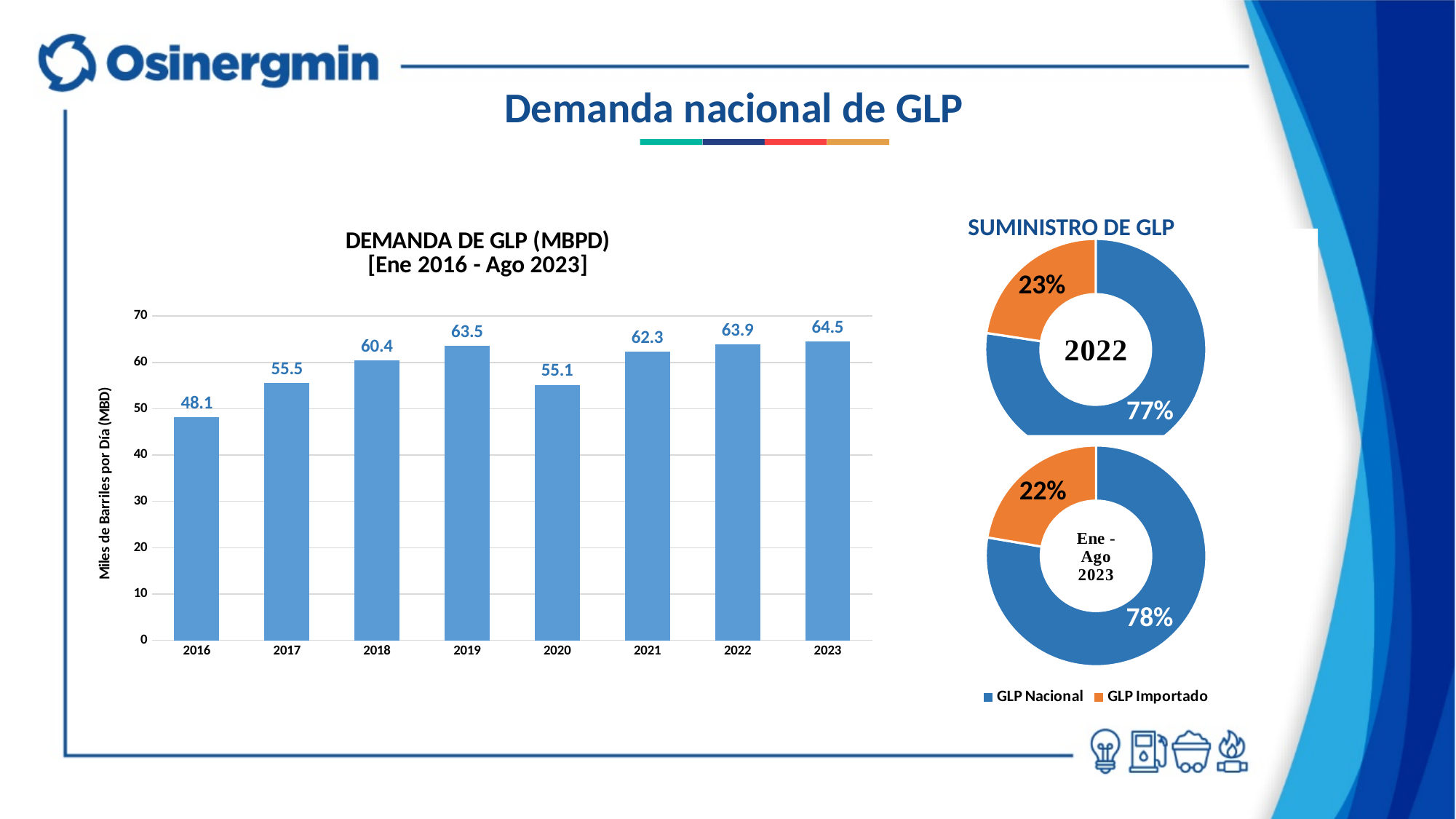
In the SUMINISTRO DE GLP 2022 donut chart, what share is GLP Importado? 23% In the SUMINISTRO DE GLP Ene - Ago 2023 donut chart, what share is GLP Nacional? 78% In the DEMANDA DE GLP (MBPD) bar chart, which year has the lowest value? 2016 In the DEMANDA DE GLP (MBPD) bar chart, which is larger, the value for 2018 or the value for 2021? 2021 In the DEMANDA DE GLP (MBPD) bar chart, what is the y-axis label? Miles de Barriles por Día (MBD) What kind of chart is the DEMANDA DE GLP (MBPD) chart? Bar chart In the DEMANDA DE GLP (MBPD) bar chart, what is the difference between the values for 2019 and 2020? 8.4 In the DEMANDA DE GLP (MBPD) bar chart, which year has the highest value? 2023 In the DEMANDA DE GLP (MBPD) bar chart, how many years are shown on the x axis? 8 In the DEMANDA DE GLP (MBPD) bar chart, what is the value for 2016? 48.1 In the DEMANDA DE GLP (MBPD) bar chart, what is the value for 2020? 55.1 How many entries does the legend of the SUMINISTRO DE GLP charts list? 2